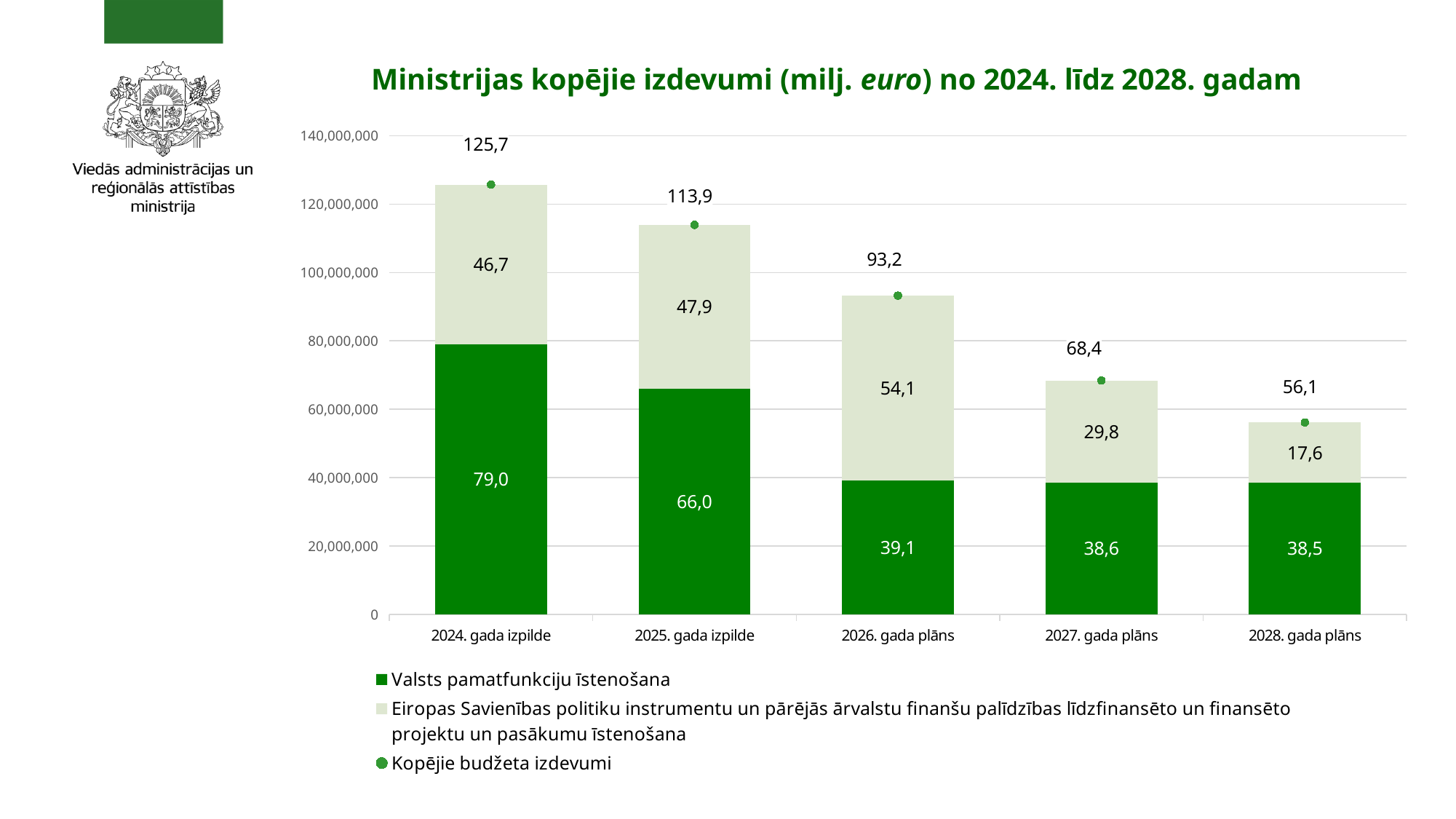
What is the value for Valsts pamatfunkciju īstenošana in 2024. gada izpilde? 79,0 What kind of chart is shown on the slide? Stacked bar chart with a point series for totals What is the difference between the Valsts pamatfunkciju īstenošana values for 2024. gada izpilde and 2025. gada izpilde? 13,0 How many series does the legend list? 3 What is the Kopējie budžeta izdevumi value for 2027. gada plāns? 68,4 What is the title of the chart? Ministrijas kopējie izdevumi (milj. euro) no 2024. līdz 2028. gadam Which is larger: the Eiropas Savienības series value for 2025. gada izpilde or for 2027. gada plāns? 2025. gada izpilde Do the Kopējie budžeta izdevumi values rise or fall from 2024. gada izpilde to 2028. gada plāns? Fall Which category has the highest Kopējie budžeta izdevumi value? 2024. gada izpilde How many categories are shown on the x axis? 5 What is the value of the Eiropas Savienības politiku instrumentu... series for 2026. gada plāns? 54,1 Which category has the lowest value for the Eiropas Savienības politiku instrumentu... series? 2028. gada plāns